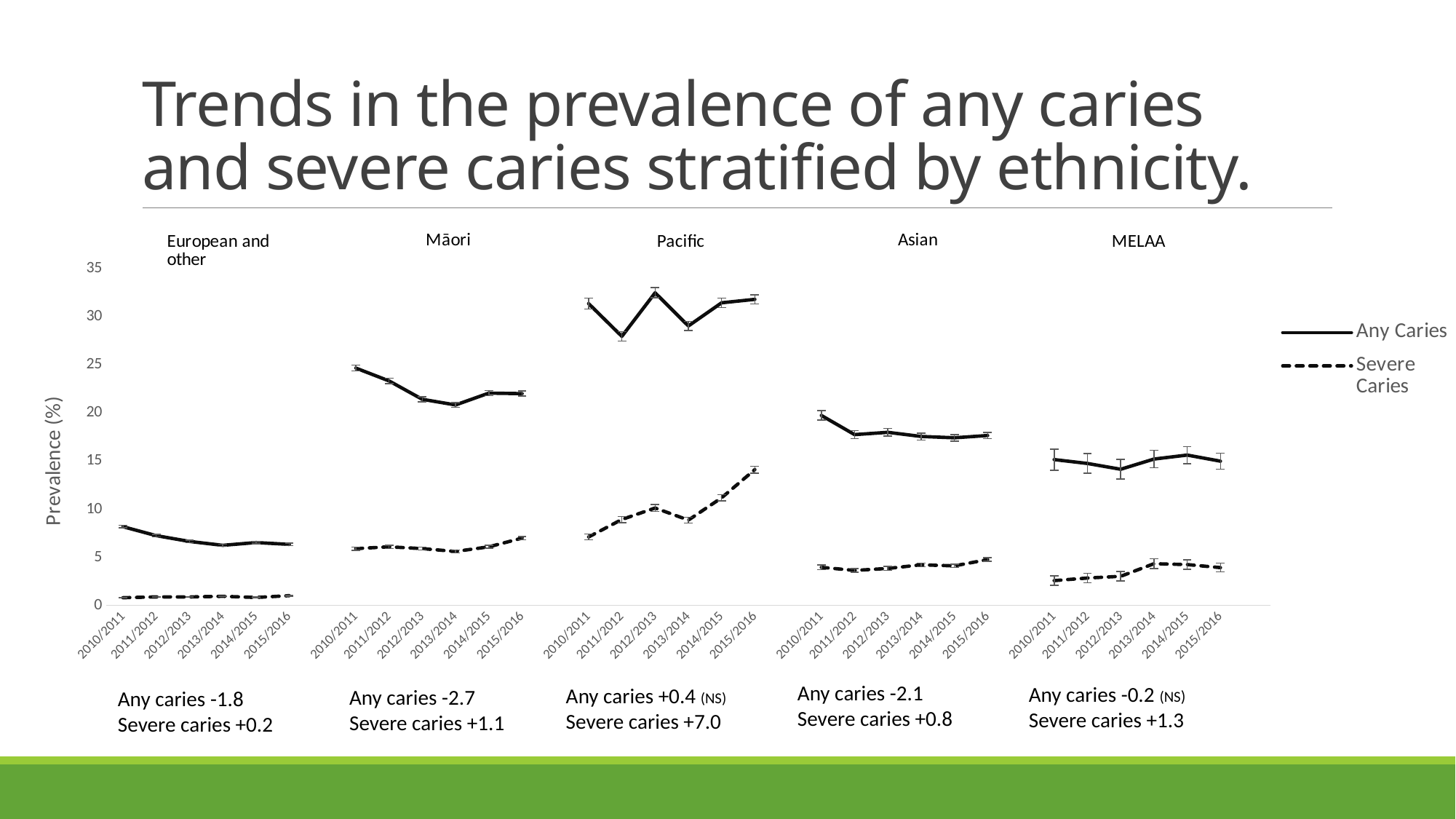
Does the Severe Caries line for Pacific rise or fall from 2010/2011 to 2015/2016? rise How many time points are plotted for each ethnic group? 6 Is the Severe Caries value for Pacific in 2015/2016 greater or less than 10? greater Is the Any Caries value for European and other in 2010/2011 greater or less than 10? less Which is larger in 2010/2011: the Any Caries value for Māori or for Asian? Māori Which ethnic group has the highest Any Caries prevalence? Pacific How many ethnic groups are shown in the chart? 5 What change in severe caries is printed below the Pacific group? +7.0 Is the Any Caries value for Pacific in 2012/2013 greater or less than 30? greater What kind of chart is shown on the slide? line chart How many series does the legend list? 2 Which ethnic group has the lowest Severe Caries prevalence? European and other